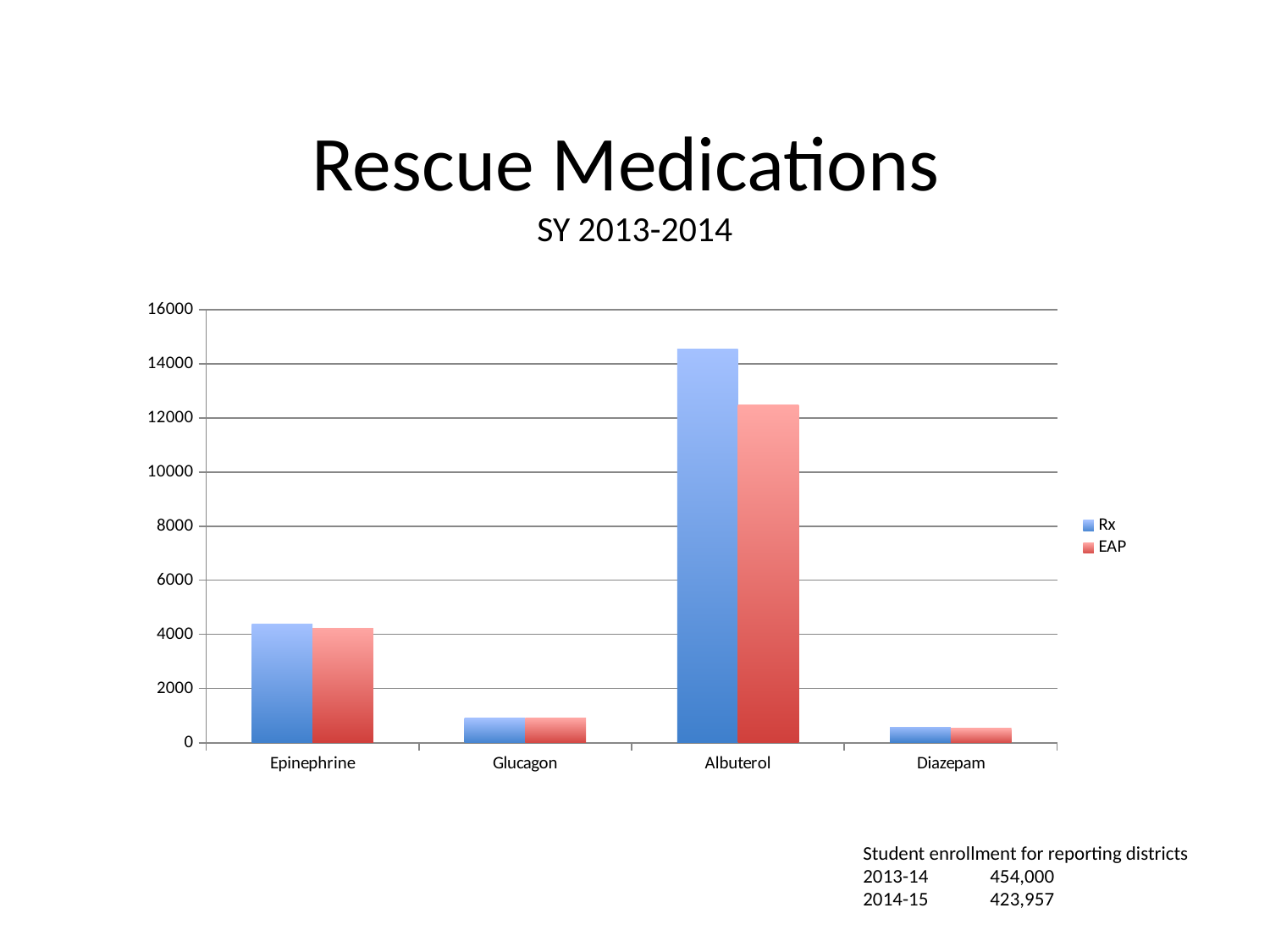
Which medication has the lowest EAP value? Diazepam Is the Rx value for Epinephrine greater or less than 4000? greater Is the Rx value for Glucagon greater or less than 2000? less How many medication categories are shown on the x axis? 4 Is the Rx value for Albuterol greater or less than 14000? greater What kind of chart is shown on the slide? bar chart Which medication has the highest Rx value? Albuterol For Albuterol, which is larger, the Rx value or the EAP value? Rx How many series does the legend list? 2 What school year does the chart title refer to? SY 2013-2014 What are the two series named in the legend? Rx and EAP